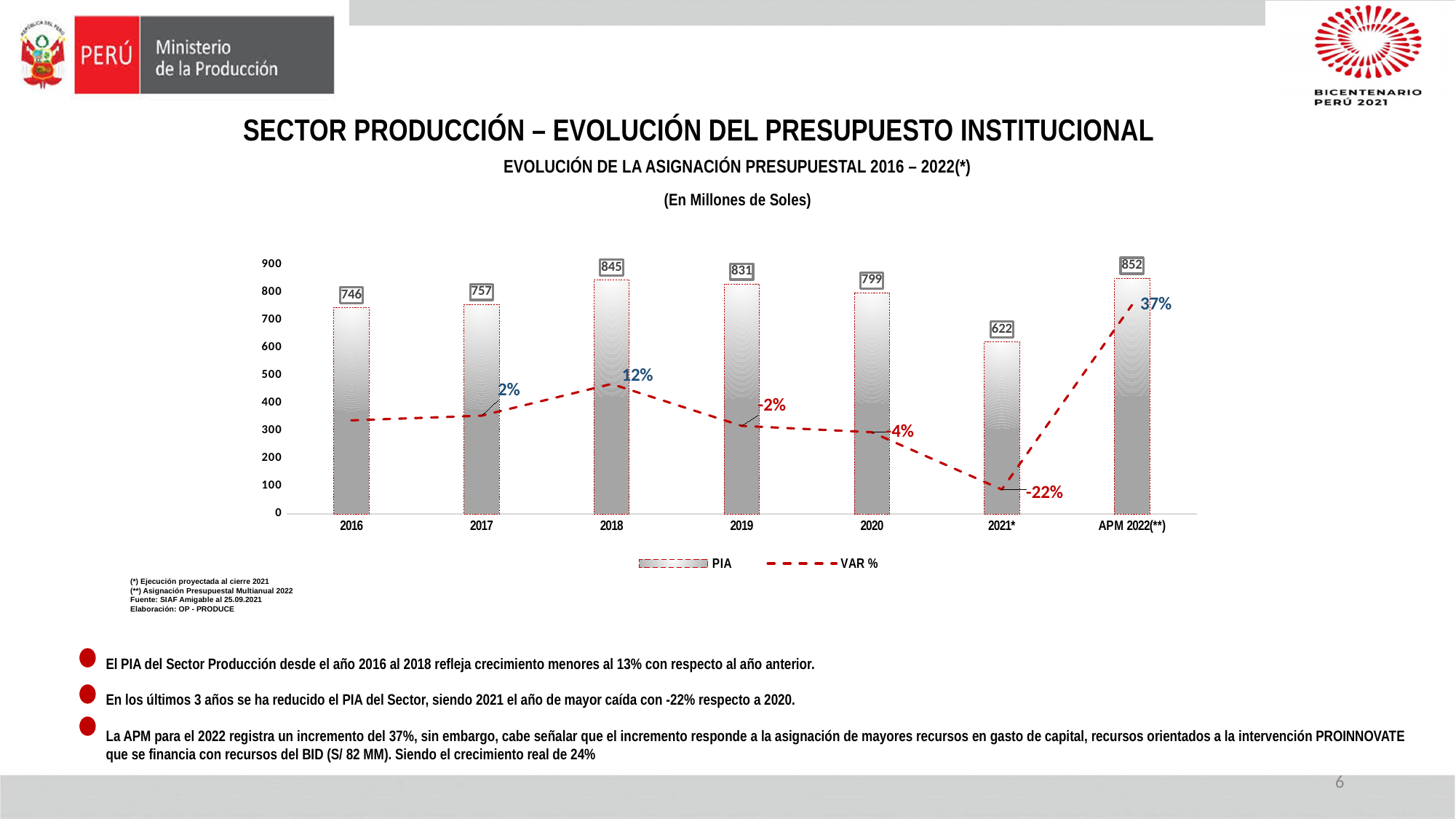
Which category has the lowest PIA value? 2021* What is the PIA value for 2021*? 622 How many categories are shown on the x axis? 7 What is the difference between the PIA values for 2018 and 2019? 14 Which is larger, the PIA value for 2016 or for 2017? 2017 What is the unit stated in the chart subtitle? En Millones de Soles Do the PIA values rise or fall from 2019 to 2021*? fall How many series does the legend list? 2 What is the VAR % value shown for APM 2022(**)? 37% Which category has the highest PIA value? APM 2022(**) What is the PIA value for 2018? 845 What is the VAR % value shown for 2020? -4%